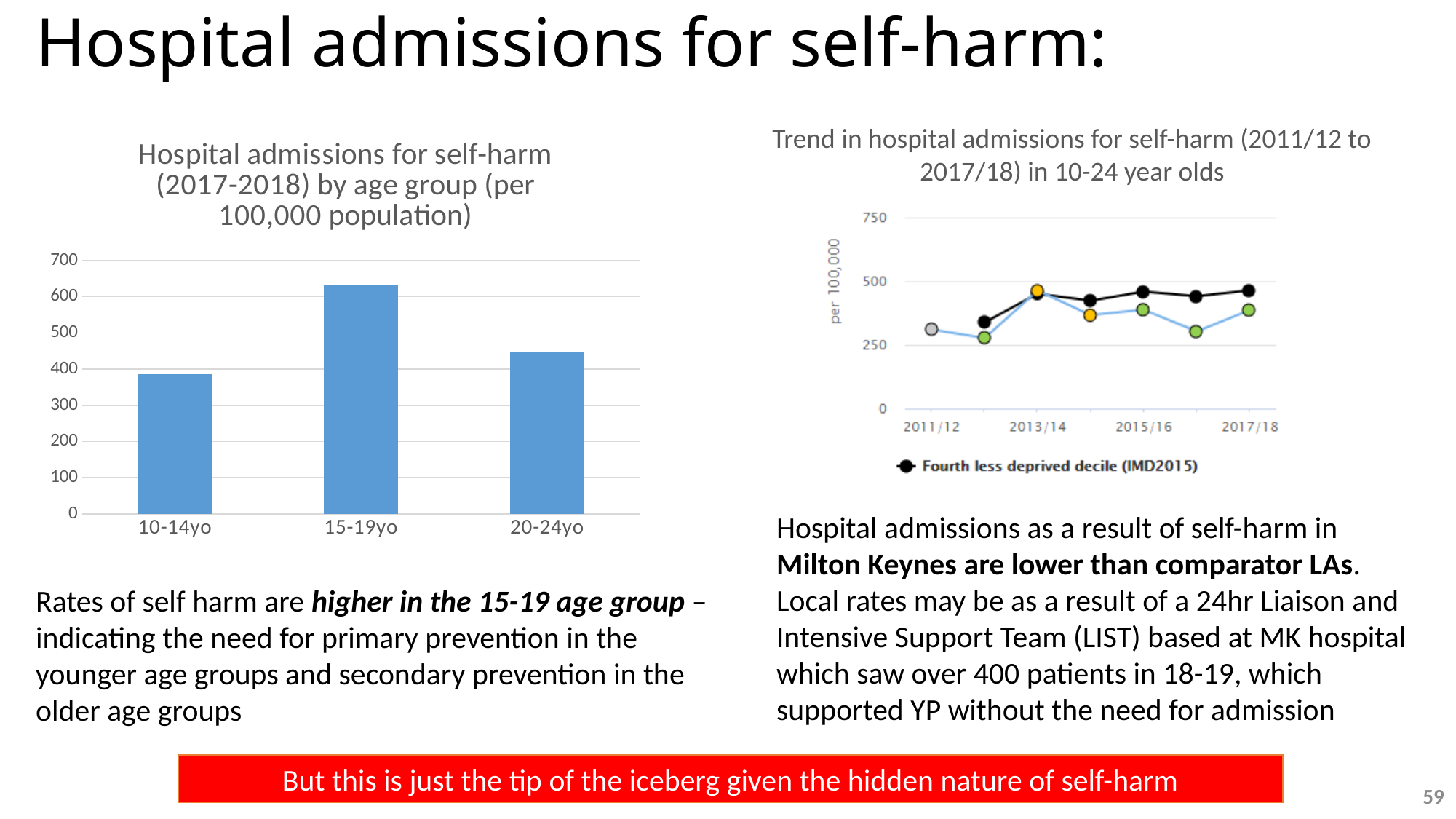
In the left chart, which has the larger value: 20-24yo or 10-14yo? 20-24yo In the left chart, which age group has the highest rate of hospital admissions for self-harm? 15-19yo In the left chart, 'Hospital admissions for self-harm (2017-2018) by age group', what kind of chart is used? Bar chart In the right chart, is the value of the black line (Fourth less deprived decile) for 2017/18 greater or less than 500? less In the left chart, which age group has the lowest rate of hospital admissions for self-harm? 10-14yo In the left chart, is the value for 10-14yo greater or less than 400? less In the left chart, what is the highest value shown on the vertical axis? 700 In the left chart, how many age groups are shown on the x axis? 3 In the right chart, what series name is shown in the legend? Fourth less deprived decile (IMD2015) In the right chart, 'Trend in hospital admissions for self-harm (2011/12 to 2017/18) in 10-24 year olds', what kind of chart is used? Line chart In the left chart, is the value for 20-24yo greater or less than 500? less